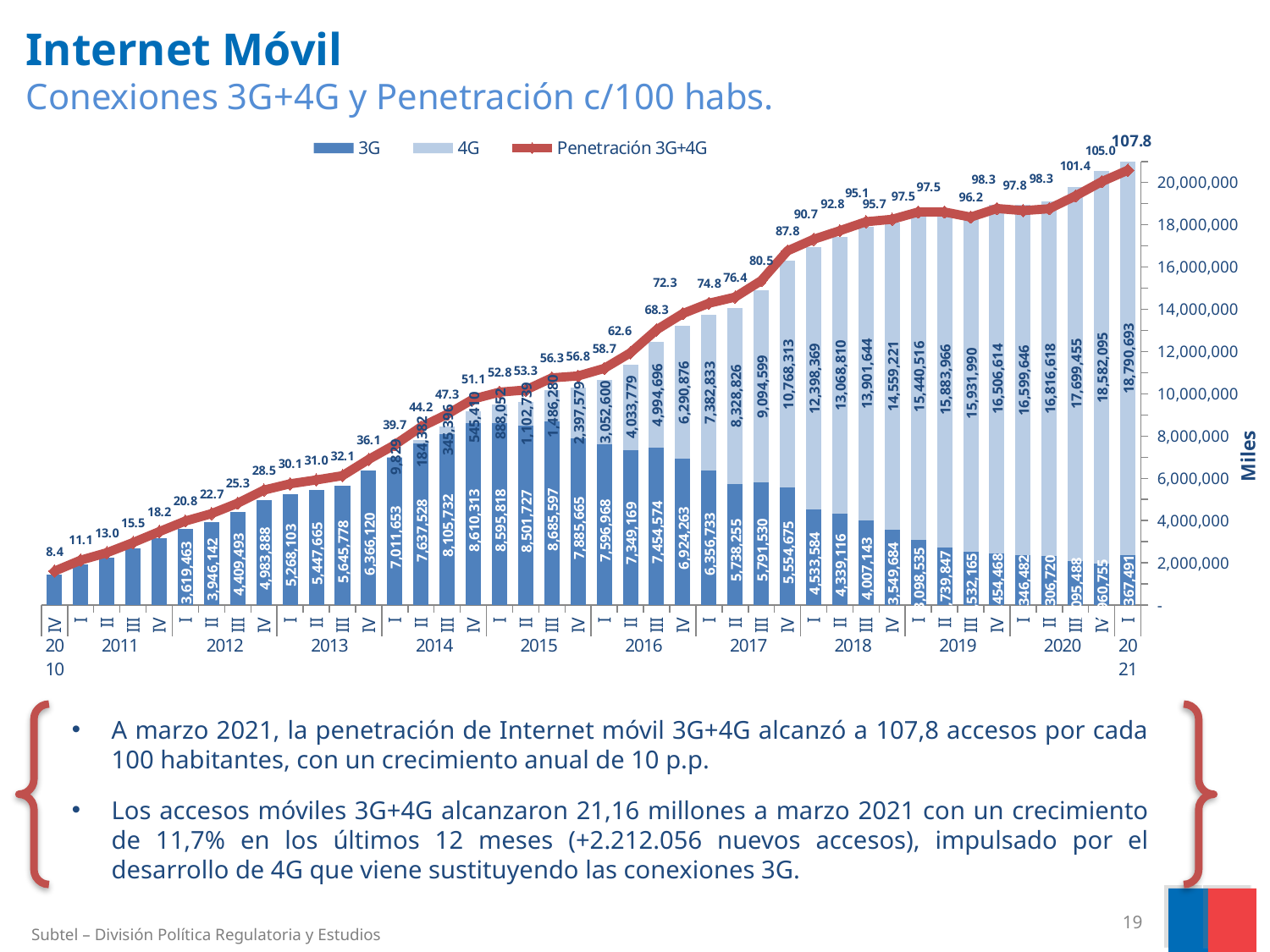
How many series does the legend list? 3 What is the total of the 3G and 4G bars for IV 2017? 16,322,988 What kind of chart is shown on the slide? A combination chart with stacked bars and a line In which period is Penetración 3G+4G highest? I 2021 What is the Penetración 3G+4G value for I 2021? 107.8 By how much did Penetración 3G+4G increase from IV 2020 to I 2021? 2.8 What is the Penetración 3G+4G value for IV 2016? 72.3 What is the 3G value for I 2013? 5,268,103 In which period is Penetración 3G+4G lowest? IV 2010 Does Penetración 3G+4G generally rise or fall from IV 2010 to I 2021? Rise What is the 4G value for IV 2020? 18,582,095 Which is larger, the 3G value for III 2014 or the 3G value for I 2021? III 2014